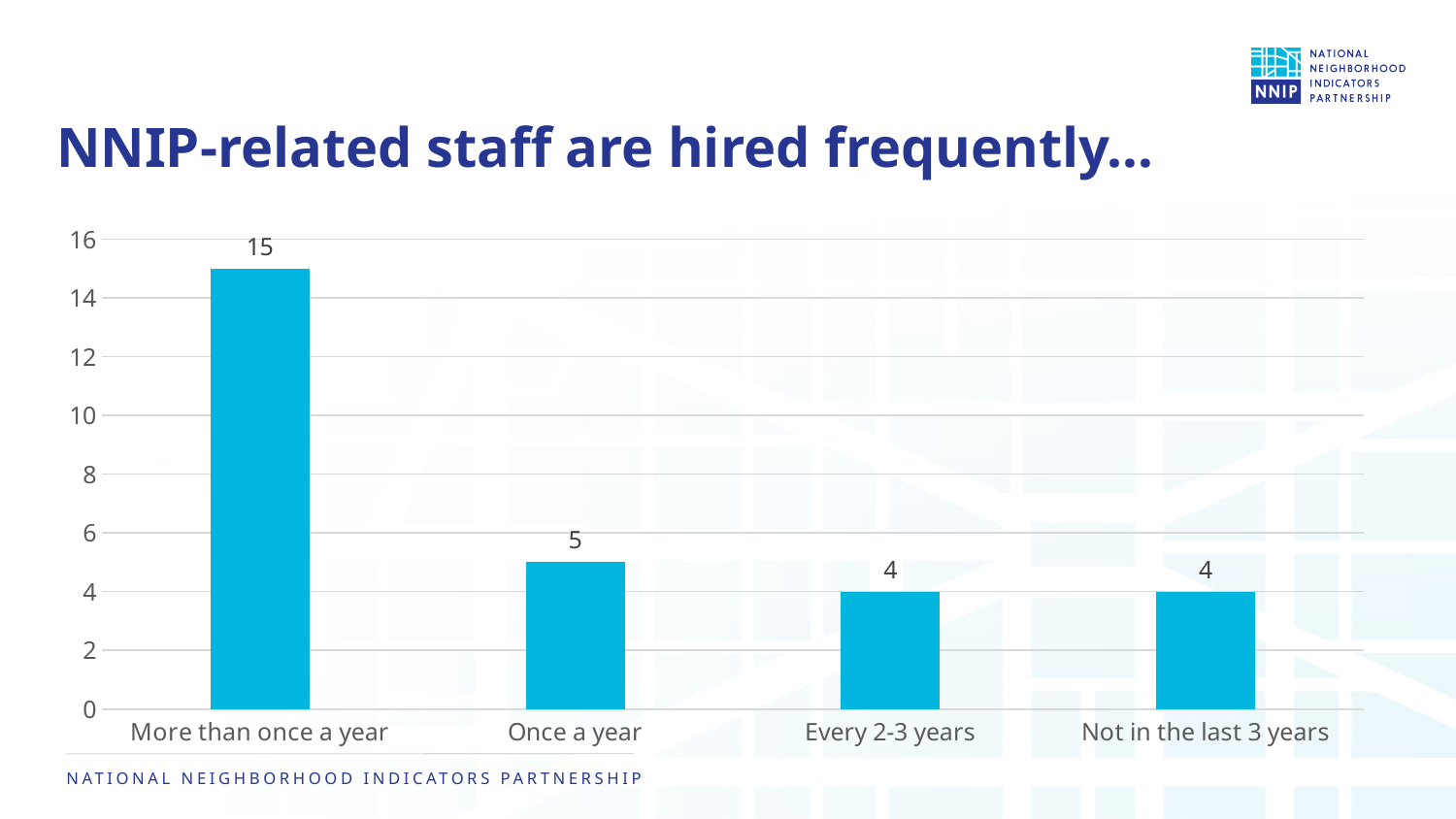
What is the value for "Once a year"? 5 Do the values rise or fall from left to right along the x axis? Fall Is the value for "More than once a year" greater or less than 10? greater How many categories are shown on the x axis? 4 What kind of chart is shown on the slide? Bar chart Which category has the highest value? More than once a year What is the difference between the values for "More than once a year" and "Once a year"? 10 What is the value for "Not in the last 3 years"? 4 What is the title of the slide? NNIP-related staff are hired frequently… What is the value for "Every 2-3 years"? 4 What is the value for "More than once a year"? 15 Which is larger, the value for "Once a year" or the value for "Every 2-3 years"? Once a year